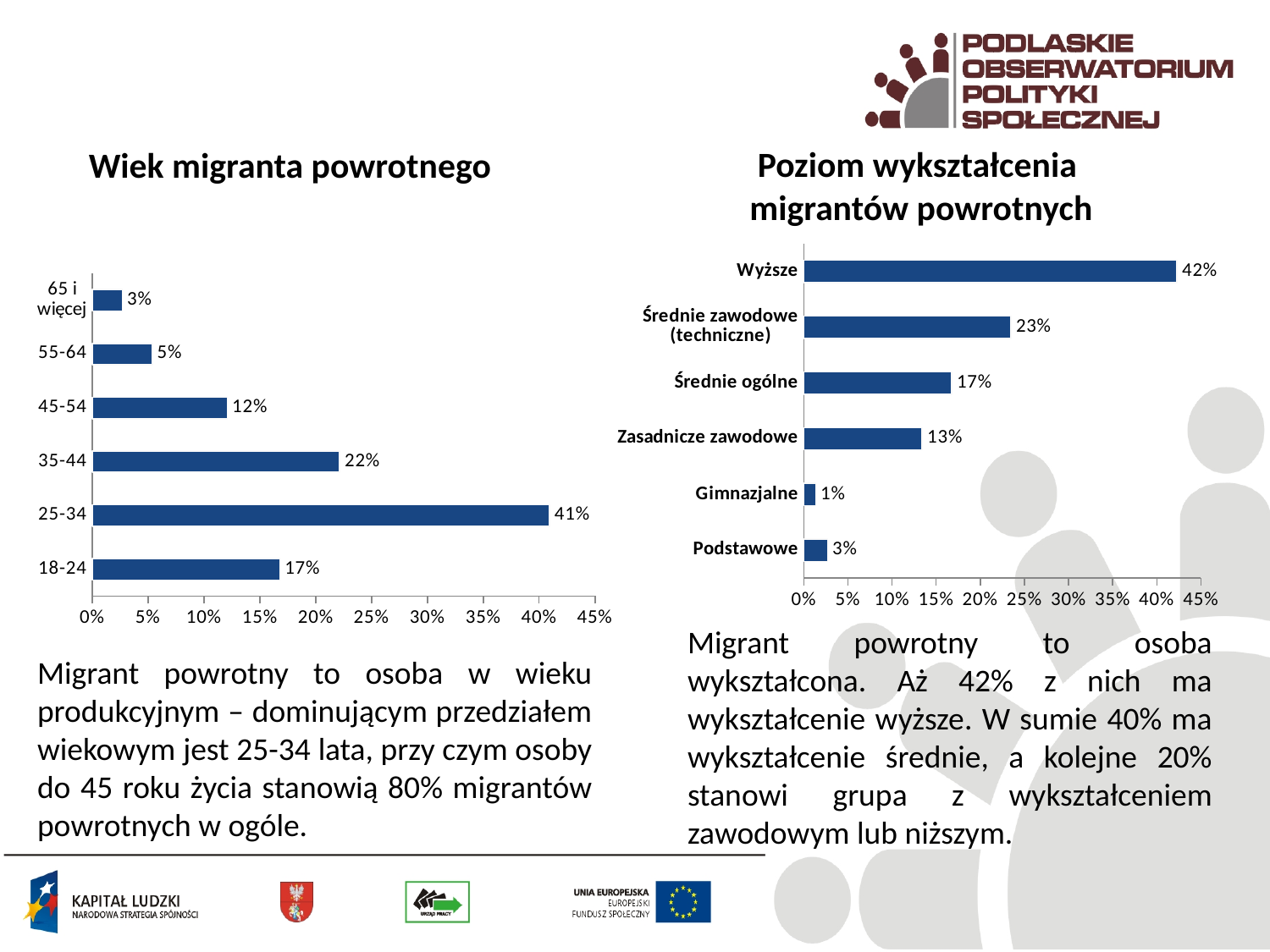
In the 'Wiek migranta powrotnego' chart, which is larger, the value for 45-54 or for 55-64? 45-54 In the 'Poziom wykształcenia migrantów powrotnych' chart, which category has the lowest value? Gimnazjalne In the 'Poziom wykształcenia migrantów powrotnych' chart, what is the value for Wyższe? 42% In the 'Wiek migranta powrotnego' chart, what is the value for the 18-24 age group? 17% In the 'Wiek migranta powrotnego' chart, what is the value for the 25-34 age group? 41% In the 'Poziom wykształcenia migrantów powrotnych' chart, how many education categories are shown? 6 In the 'Poziom wykształcenia migrantów powrotnych' chart, what is the value for Zasadnicze zawodowe? 13% In the 'Wiek migranta powrotnego' chart, which age group has the lowest value? 65 i więcej What type of chart is the 'Poziom wykształcenia migrantów powrotnych' chart? Bar chart In the 'Poziom wykształcenia migrantów powrotnych' chart, what is the difference between Średnie zawodowe (techniczne) and Średnie ogólne? 6% In the 'Wiek migranta powrotnego' chart, how many age categories are shown? 6 In the 'Wiek migranta powrotnego' chart, what is the difference between the values for 25-34 and 35-44? 19%